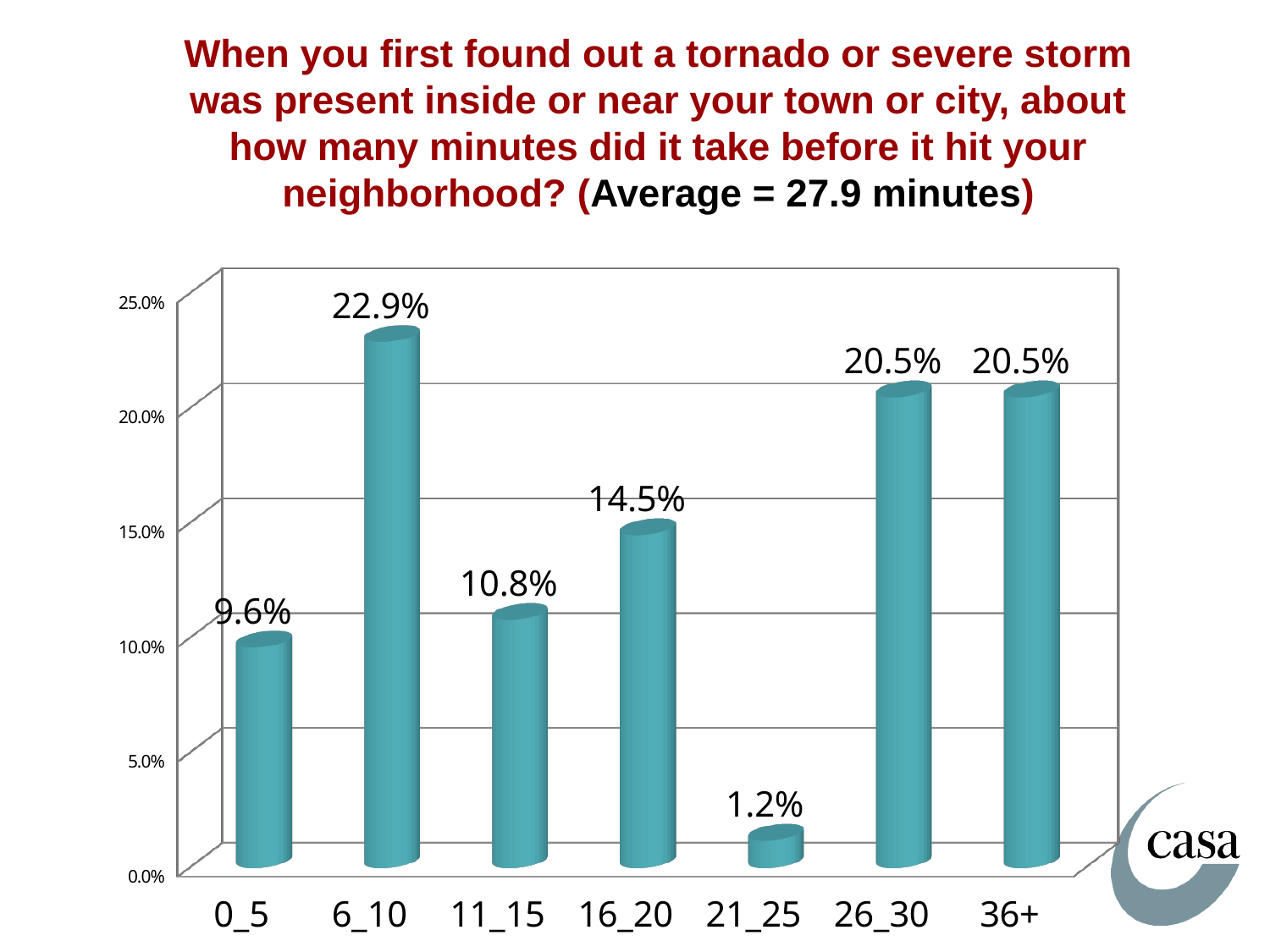
How many categories are shown on the x axis? 7 What is the value shown for the 16_20 category? 14.5% What is the difference between the values for 6_10 and 11_15? 12.1% Which is larger, the value for 0_5 or the value for 11_15? 11_15 Which category has the highest percentage? 6_10 What percentage of respondents said it took 6_10 minutes before the storm hit their neighborhood? 22.9% Which category has the lowest percentage? 21_25 What is the value shown for the 0_5 category? 9.6% What kind of chart is shown on the slide? Bar chart What is the difference between the values for 16_20 and 21_25? 13.3% What average number of minutes is stated in the chart title? 27.9 minutes What is the value shown for the 21_25 category? 1.2%